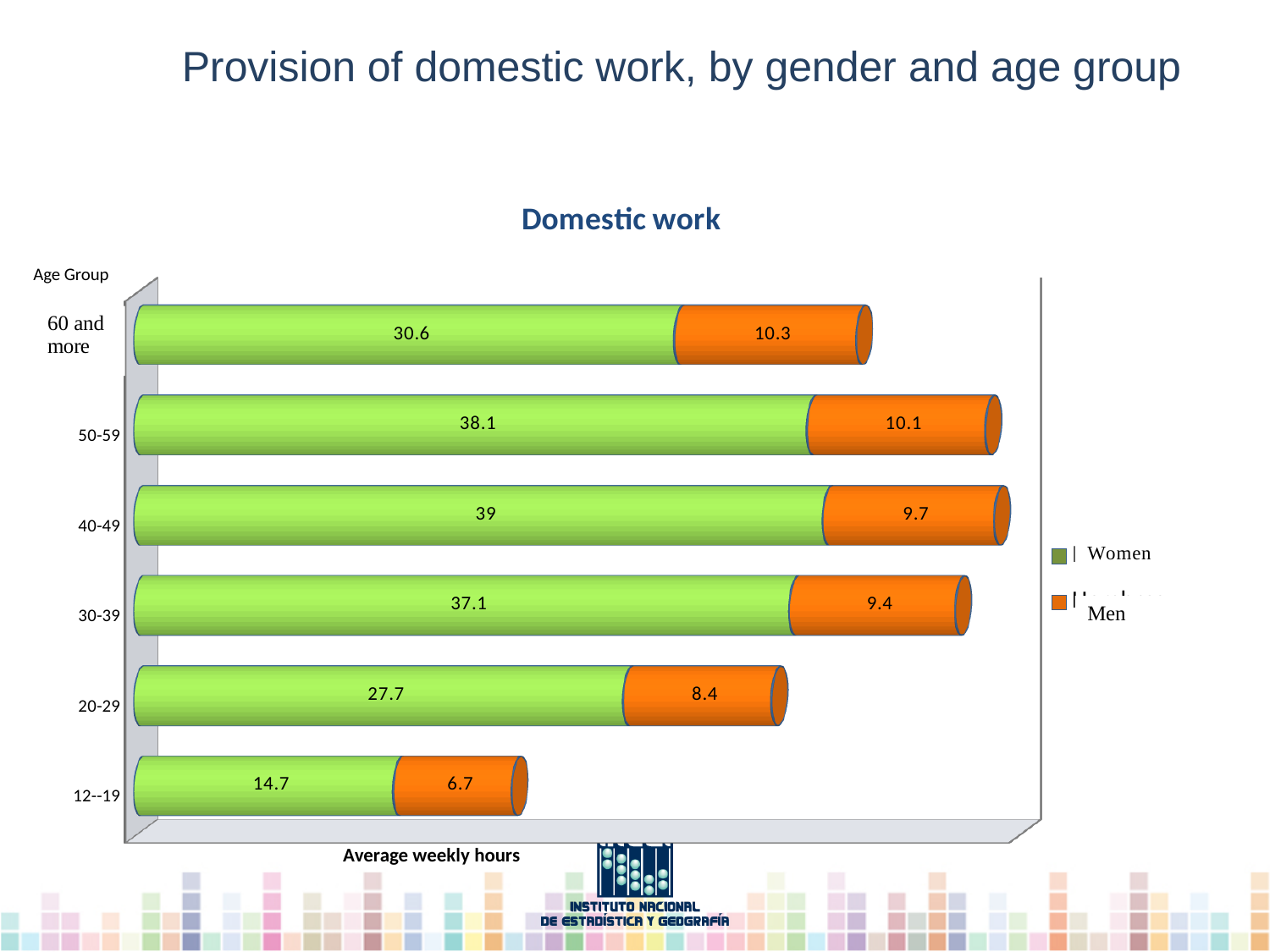
What is the value for Men in the 12--19 age group? 6.7 What is the value for Women in the 60 and more age group? 30.6 What kind of chart is shown on the slide? Stacked bar chart Which age group has the highest value for Women? 40-49 How many age groups are shown on the chart? 6 Which is larger: the Men value for 60 and more or the Men value for 20-29? 60 and more How many series does the legend list? 2 Which age group has the lowest value for Men? 12--19 What is the value for Women in the 40-49 age group? 39 What is the difference between the Women and Men values in the 50-59 age group? 28 What is the total of the stacked bar for the 30-39 age group? 46.5 What is the title of the chart? Domestic work